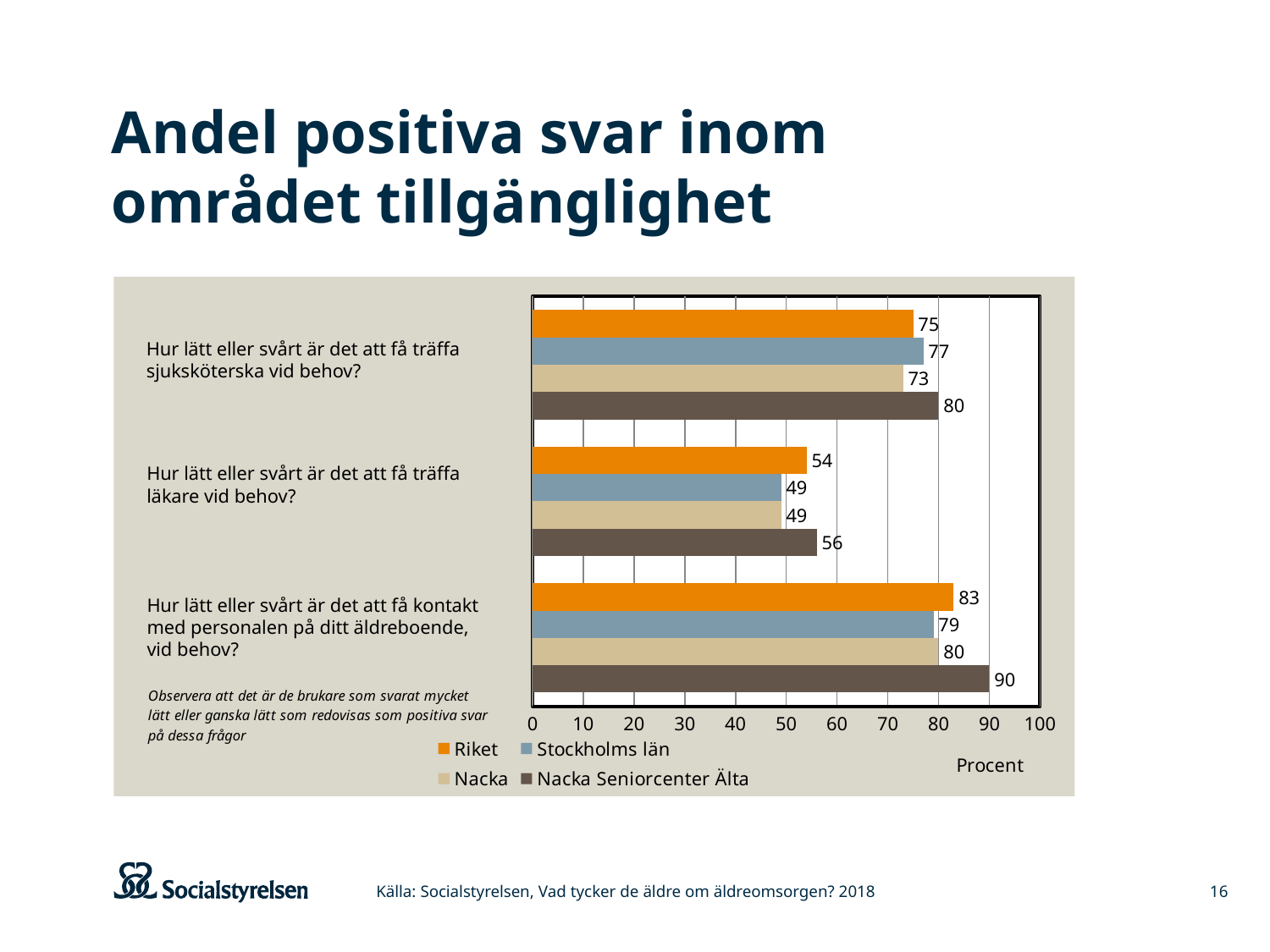
Which series has the lowest value on the question "Hur lätt eller svårt är det att få kontakt med personalen på ditt äldreboende, vid behov?"? Stockholms län How many series does the legend list? 4 What is the value for Nacka Seniorcenter Älta on the question "Hur lätt eller svårt är det att få kontakt med personalen på ditt äldreboende, vid behov?"? 90 What kind of chart is shown on the slide? Bar chart What is the value for Nacka on the question "Hur lätt eller svårt är det att få träffa sjuksköterska vid behov?"? 73 What is the value for Riket on the question "Hur lätt eller svårt är det att få träffa läkare vid behov?"? 54 Which series has the highest value on the question "Hur lätt eller svårt är det att få träffa sjuksköterska vid behov?"? Nacka Seniorcenter Älta Which is larger on the question "Hur lätt eller svårt är det att få träffa sjuksköterska vid behov?": Riket or Stockholms län? Stockholms län What is the value for Stockholms län on the question "Hur lätt eller svårt är det att få kontakt med personalen på ditt äldreboende, vid behov?"? 79 What is the difference between Riket and Nacka on the question "Hur lätt eller svårt är det att få träffa läkare vid behov?"? 5 What is the difference between Nacka Seniorcenter Älta and Riket on the question "Hur lätt eller svårt är det att få kontakt med personalen på ditt äldreboende, vid behov?"? 7 How many question categories are shown on the chart? 3